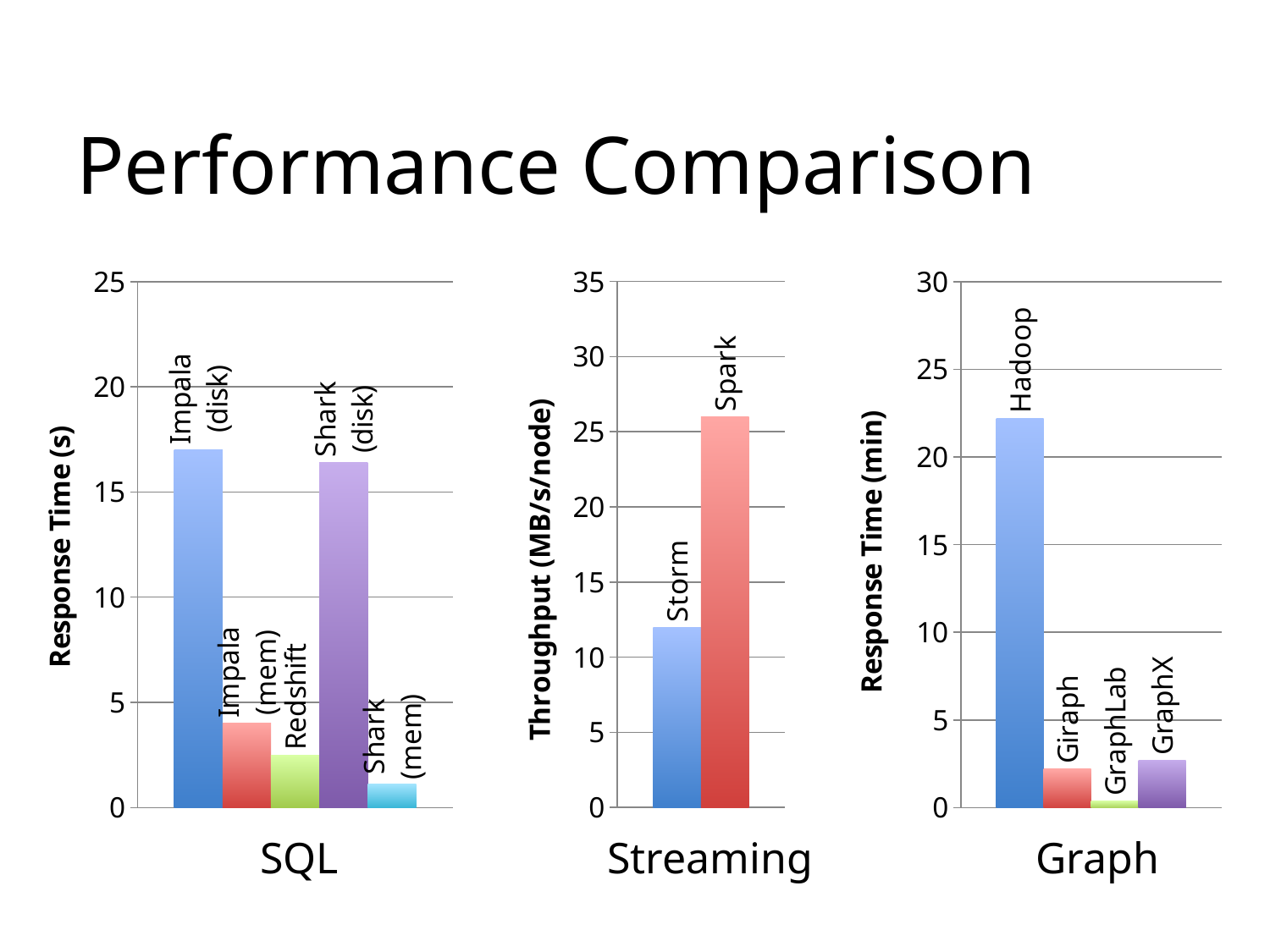
In the Graph chart, which system has the lowest response time? GraphLab In the Graph chart, which system has the highest response time? Hadoop What is the y-axis title of the Streaming chart? Throughput (MB/s/node) In the SQL chart, is the value for Impala (mem) greater or less than 5? less In the SQL chart, how many bars are plotted? 5 In the SQL chart, is the value for Impala (disk) greater or less than 15? greater In the Streaming chart, is the value for Spark greater or less than 30? less In the SQL chart, which is larger, the value for Impala (mem) or the value for Redshift? Impala (mem) In the Streaming chart, which system has the higher throughput? Spark In the SQL chart, which system has the lowest response time? Shark (mem)